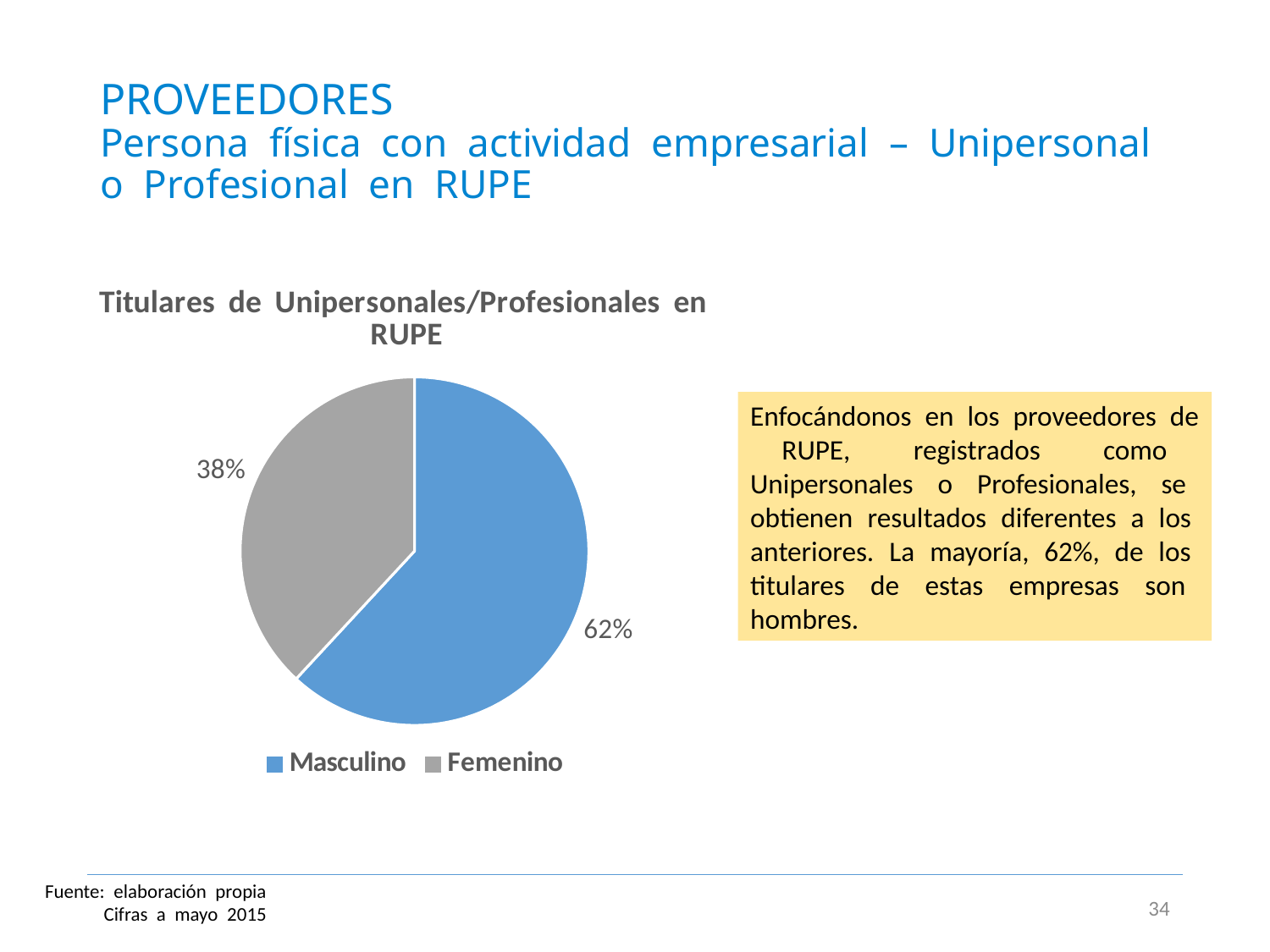
What is the difference in percentage points between Masculino and Femenino? 24 Which category has the smallest share of the pie? Femenino Which category has the largest share of the pie? Masculino What percentage of the pie is Masculino? 62% What is the title of the chart? Titulares de Unipersonales/Profesionales en RUPE Which colour represents Femenino in the pie chart? grey How many entries does the legend list? 2 Is the share for Masculino greater or less than 50%? greater What percentage of the pie is Femenino? 38% Which is larger, the share for Masculino or the share for Femenino? Masculino How many slices does the pie chart have? 2 What kind of chart is shown on the slide? pie chart